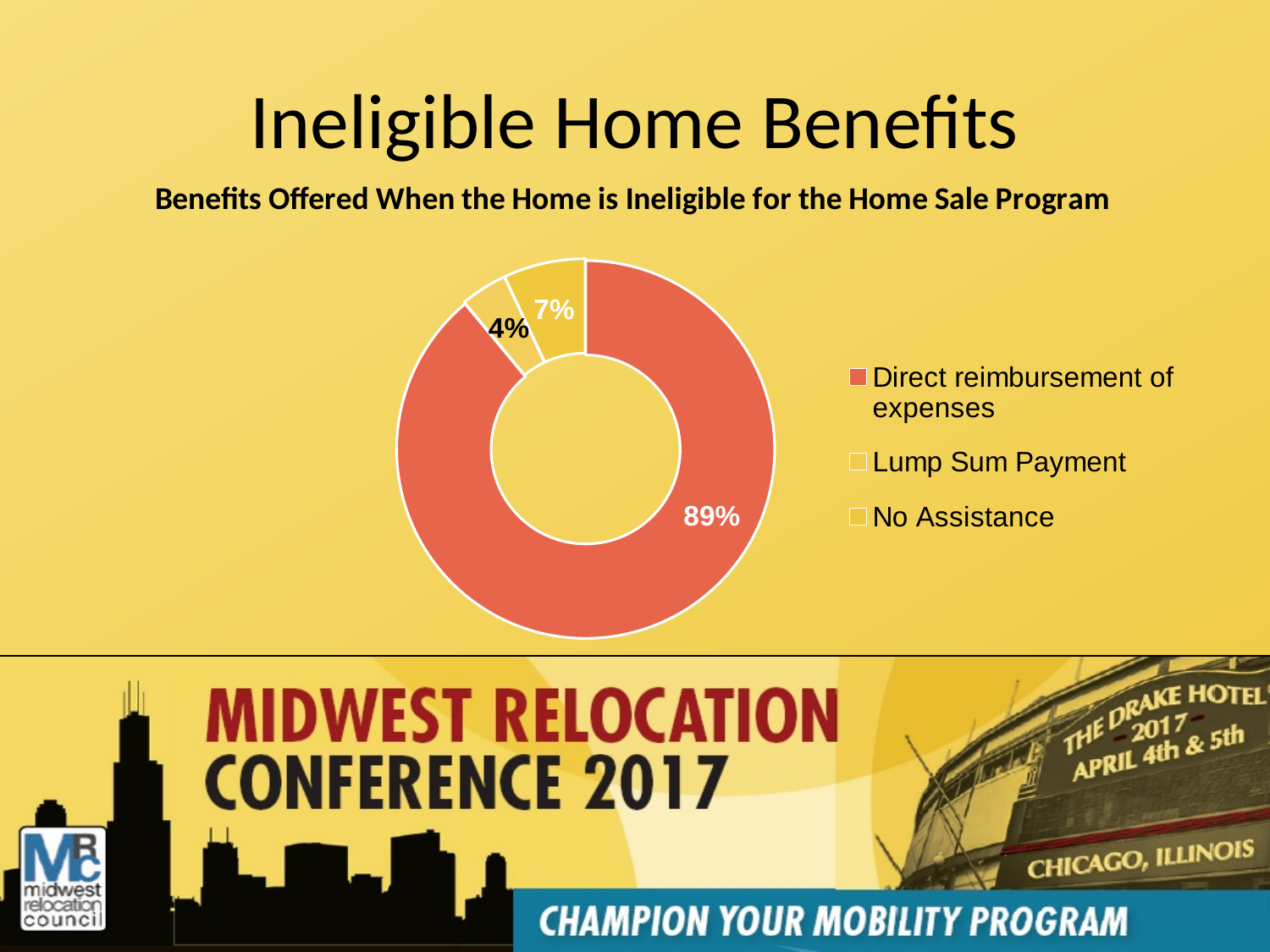
Which category has the largest share of the chart? Direct reimbursement of expenses How many categories does the legend list? 3 What is the subtitle printed above the chart? Benefits Offered When the Home is Ineligible for the Home Sale Program Which category has the smallest share of the chart? Lump Sum Payment What percentage of the chart is Lump Sum Payment? 4% Which is larger, the share for No Assistance or the share for Lump Sum Payment? No Assistance What percentage of the chart is Direct reimbursement of expenses? 89% What is the difference in percentage points between Direct reimbursement of expenses and No Assistance? 82 What colour is the Direct reimbursement of expenses slice? Red What is the difference in percentage points between No Assistance and Lump Sum Payment? 3 What percentage of the chart is No Assistance? 7% What type of chart is shown on the slide? Doughnut chart